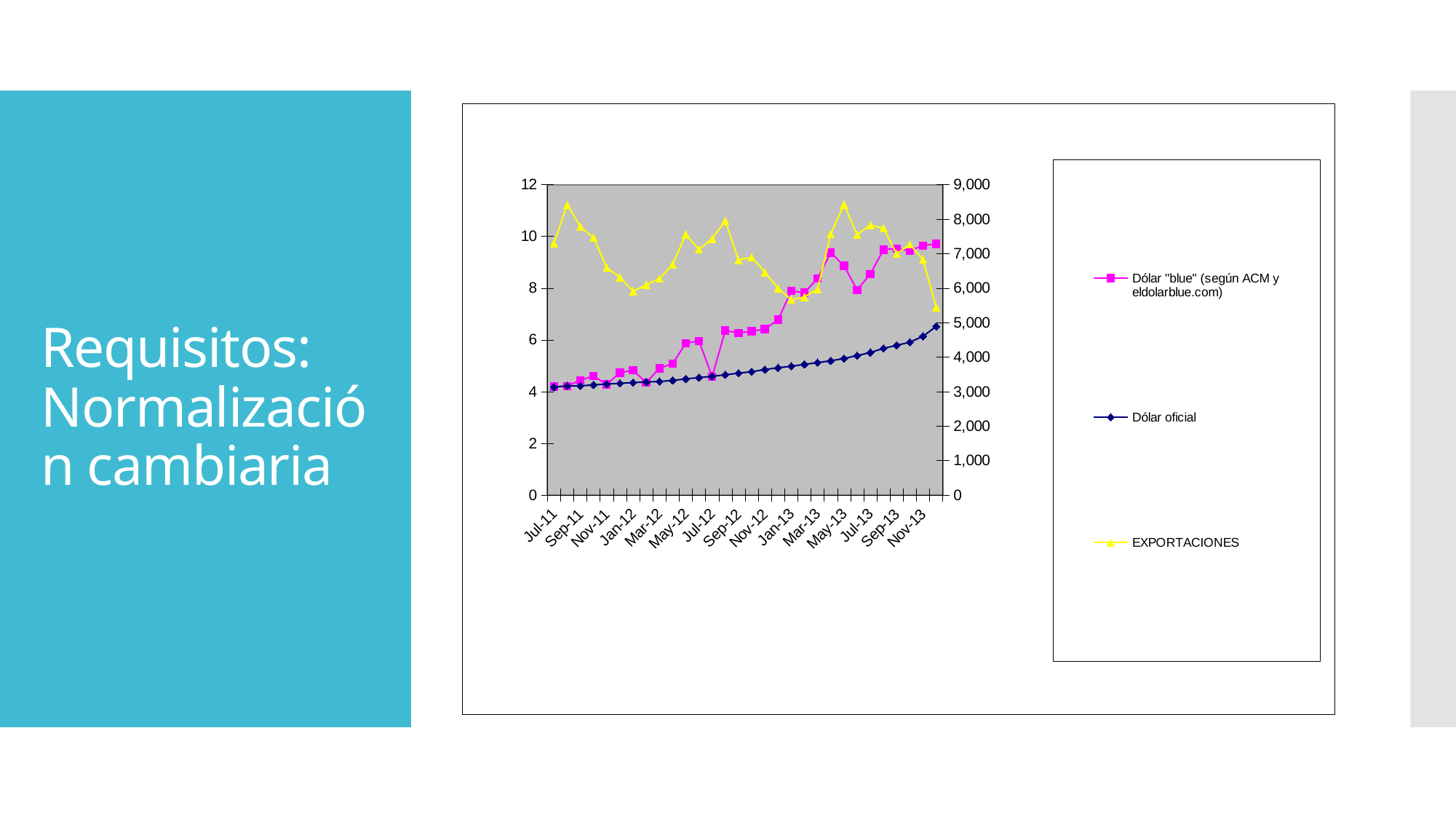
At Nov-13, which is larger on the left axis: Dólar "blue" or Dólar oficial? Dólar "blue" Is the value of Dólar "blue" at Jul-12 greater or less than 8? less Which series is drawn in yellow with triangle markers? EXPORTACIONES What kind of chart is shown on the slide? line chart Which series is drawn in magenta with square markers? Dólar "blue" (según ACM y eldolarblue.com) Is the value of Dólar "blue" at Nov-13 greater or less than 8? greater Does the Dólar "blue" series rise or fall overall from Jul-11 to Nov-13? rise How many series does the legend list? 3 Is the value of Dólar oficial at Jul-11 greater or less than 6? less How many month labels are shown on the x axis? 15 Does the Dólar oficial series rise or fall from Jul-11 to Nov-13? rise